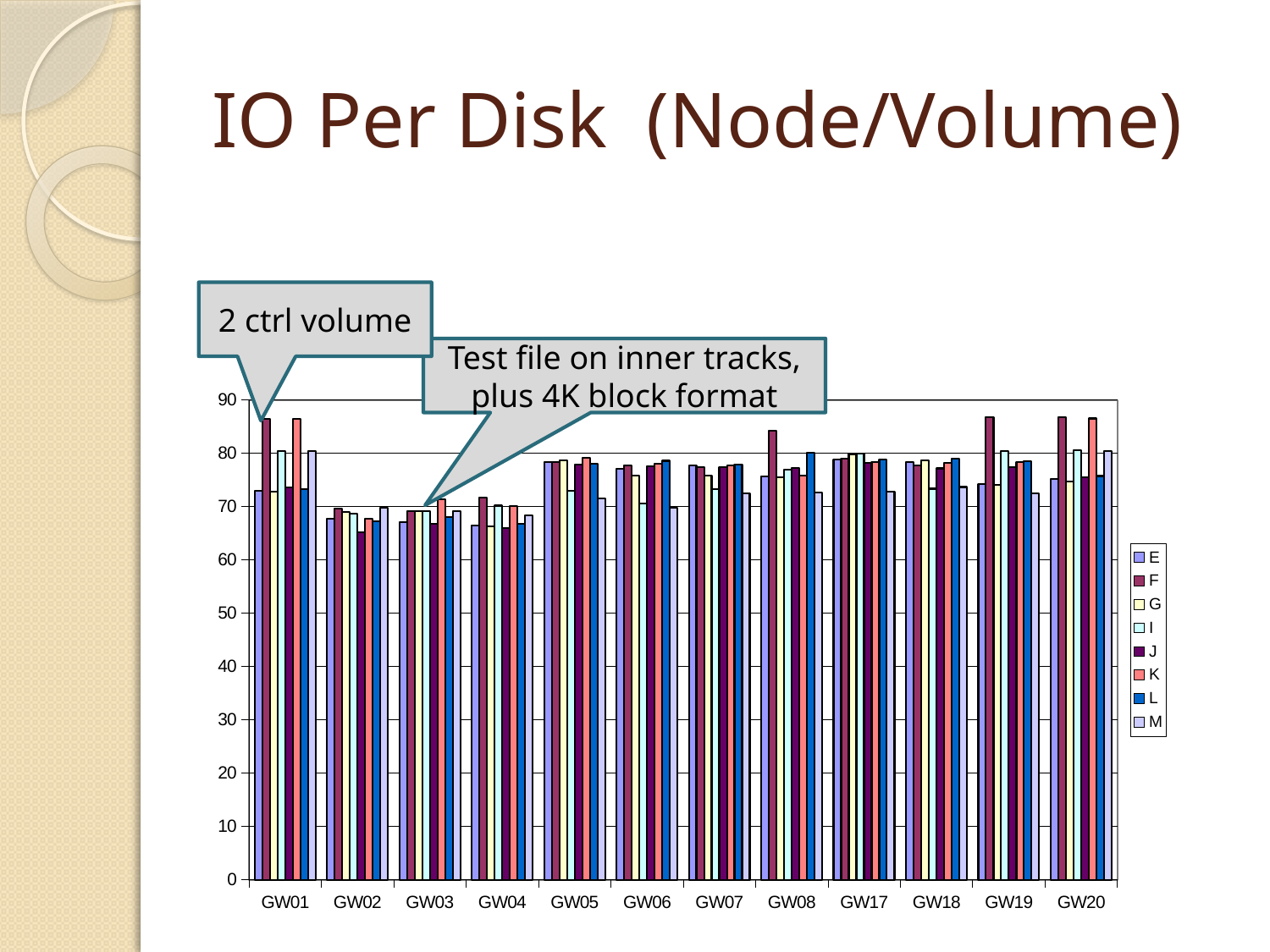
How many categories (GW nodes) are shown on the x axis? 12 Is the value for series E at GW04 greater or less than 70? less Is the value for series F at GW01 greater or less than 80? greater Is the value for series E at GW05 greater or less than 70? greater What is the title of the slide containing the chart? IO Per Disk (Node/Volume) What does the callout pointing at GW01 say? 2 ctrl volume Which series has the highest value at GW19? F Which is larger, the value for series E at GW05 or the value for series E at GW04? GW05 How many series does the legend list? 8 What kind of chart is shown on the slide? bar chart